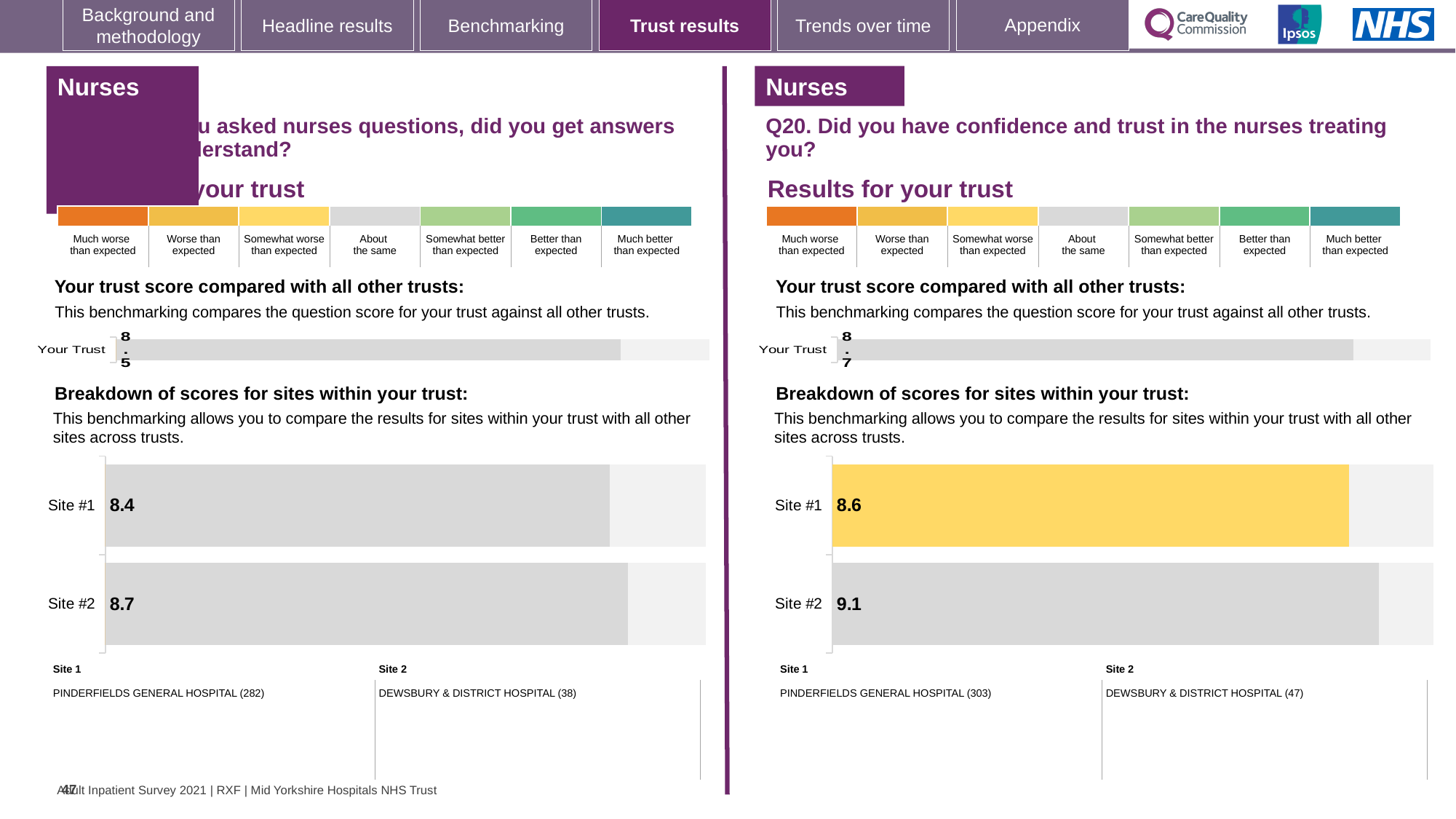
On the right-hand chart (Q20) of site scores, what is the difference between the Site #2 and Site #1 scores? 0.5 On the right-hand (Q20) 'Your trust score compared with all other trusts' chart, what is the score shown for Your Trust? 8.7 On the left-hand 'Your trust score compared with all other trusts' chart, what is the score shown for Your Trust? 8.5 On the right-hand chart (Q20) of site scores, what is the score for Site #1? 8.6 On the left-hand chart of site scores, what is the score for Site #2? 8.7 On the left-hand chart of site scores, what is the score for Site #1? 8.4 On the left-hand chart of site scores, which site has the lower score? Site #1 How many sites are shown in the right-hand (Q20) breakdown of scores chart? 2 On the left-hand chart of site scores, what is the difference between the Site #2 and Site #1 scores? 0.3 What type of chart is used for the breakdown of scores for sites on the right-hand side (Q20)? Bar chart On the right-hand chart (Q20) of site scores, which site has the higher score? Site #2 On the right-hand chart (Q20) of site scores, what is the score for Site #2? 9.1